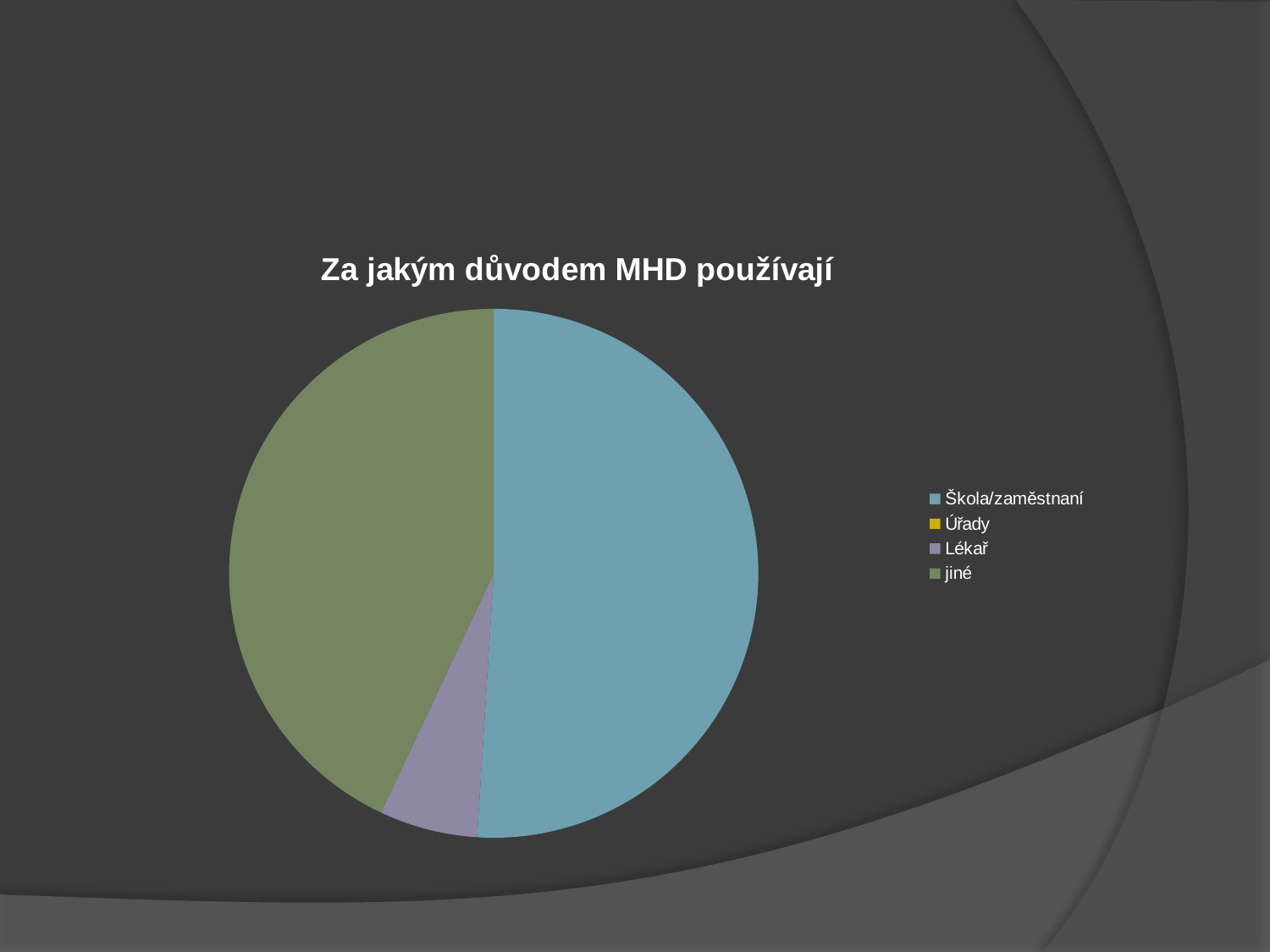
Which colour represents the category jiné in the pie chart? green What kind of chart is shown on the slide? pie chart How many entries does the chart's legend list? 4 How many categories are listed in the legend of the pie chart? 4 What is the title of the chart? Za jakým důvodem MHD používají Which is larger, the slice for Škola/zaměstnaní or the slice for Lékař? Škola/zaměstnaní Which is larger, the slice for jiné or the slice for Lékař? jiné Which legend category has no visible slice in the pie chart? Úřady